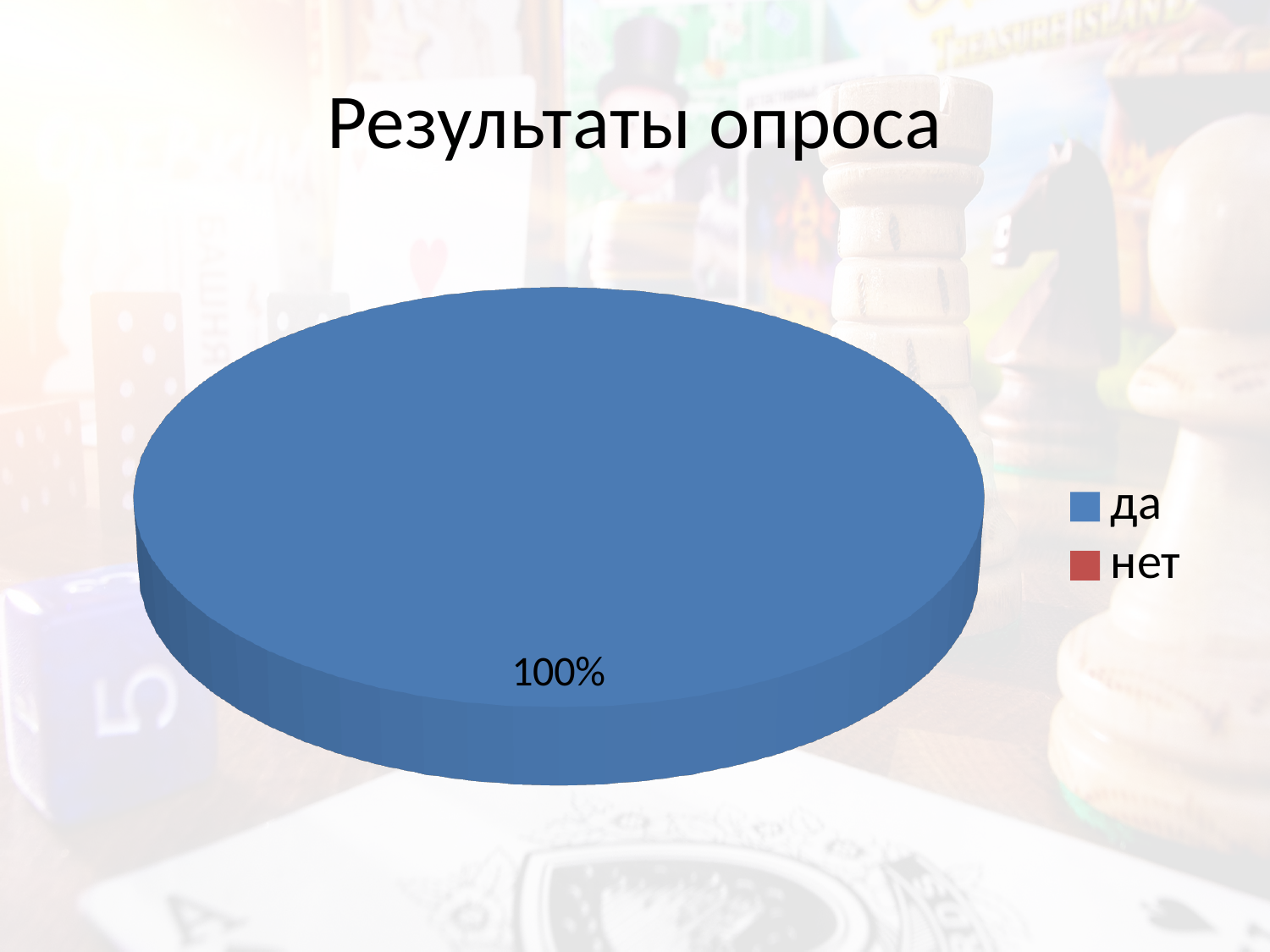
What value is printed as the data label on the pie? 100% What colour is the "да" slice in the legend? blue Which category has the smallest share of the pie? нет How many entries does the legend list? 2 Which category has the largest share of the pie? да What kind of chart is shown on the slide? pie chart What share of the pie does the "да" slice take? 100% What is the title of the chart? Результаты опроса Which is larger, the share for "да" or the share for "нет"? да